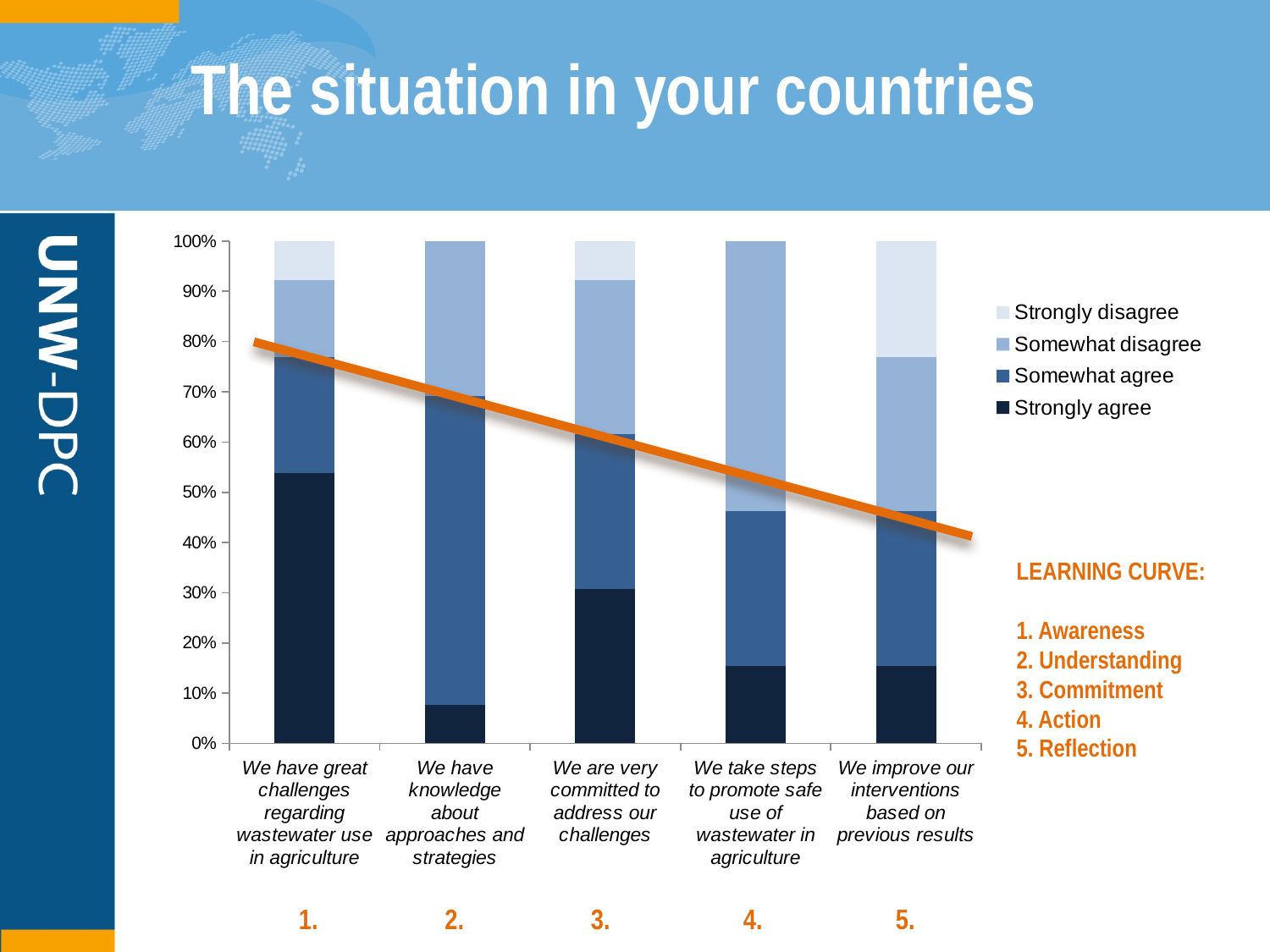
Does the orange line drawn across the chart rise or fall from left to right? Fall Which statement has the largest 'Strongly agree' share? We have great challenges regarding wastewater use in agriculture What kind of chart is shown on the slide? Stacked bar chart Is the 'Strongly agree' share for 'We have knowledge about approaches and strategies' greater or less than 10%? less Which has the larger 'Strongly agree' share: 'We are very committed to address our challenges' or 'We take steps to promote safe use of wastewater in agriculture'? We are very committed to address our challenges Is the 'Strongly agree' share for 'We are very committed to address our challenges' greater or less than 40%? less Which legend entry is shown in the darkest navy colour? Strongly agree How many of the bars have no 'Strongly disagree' segment? 2 Which statement has the smallest 'Strongly agree' share? We have knowledge about approaches and strategies How many series does the legend list? 4 How many statements (categories) are plotted along the x axis? 5 Is the 'Strongly agree' share for 'We have great challenges regarding wastewater use in agriculture' greater or less than 50%? greater